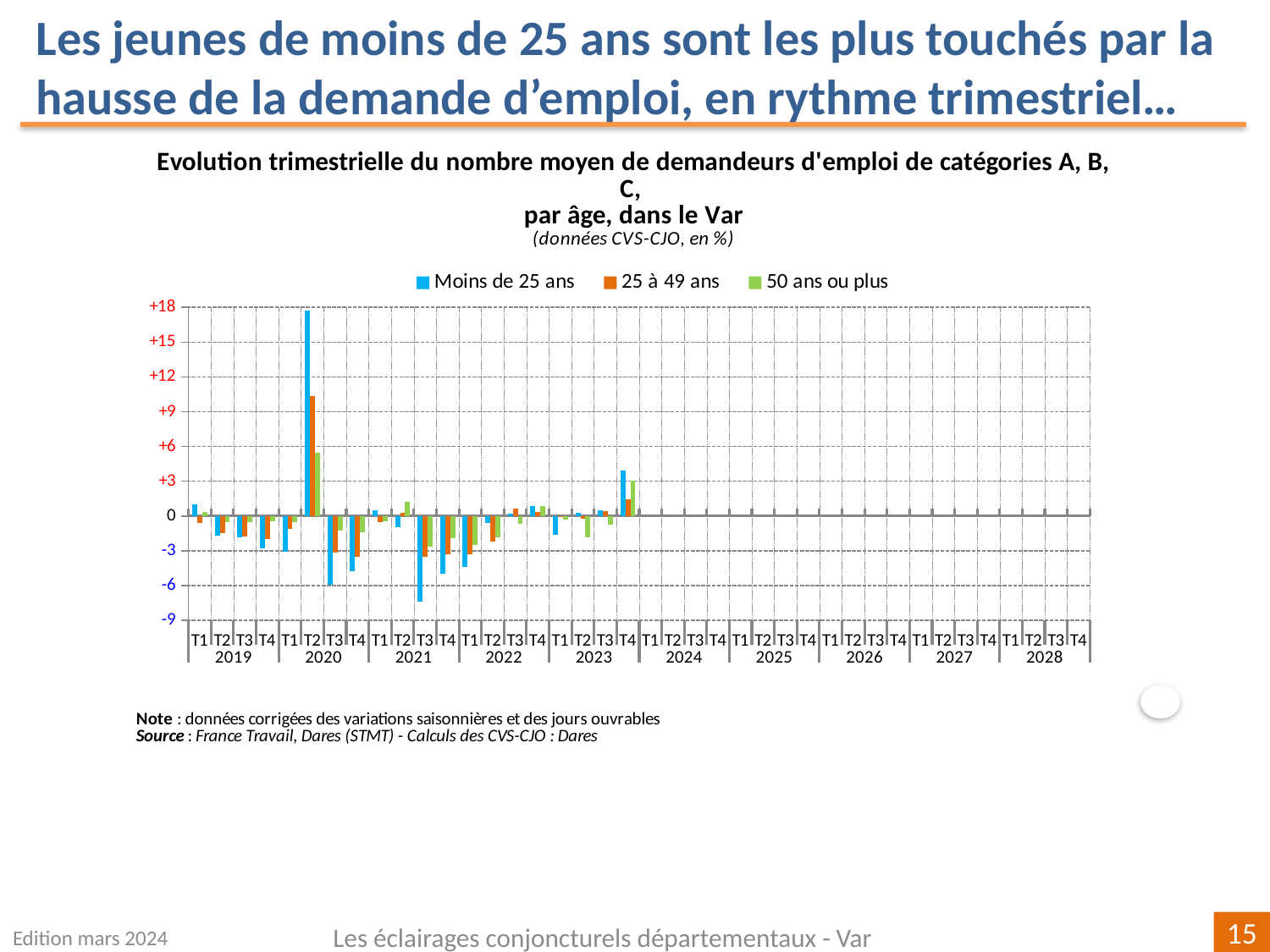
Is the value for '25 à 49 ans' in T2 2020 greater or less than +9? greater In T2 2020, which series has the larger value: 'Moins de 25 ans' or '50 ans ou plus'? Moins de 25 ans Is the value for 'Moins de 25 ans' in T4 2023 greater or less than +3? greater In which quarter does the 'Moins de 25 ans' series reach its highest value? T2 2020 How many series does the legend list? 3 Is the value for 'Moins de 25 ans' in T2 2020 greater or less than +15? greater How many years are labelled along the x axis? 10 What kind of chart is shown on the slide? Bar chart What is the last year on the x axis for which bars are plotted? 2023 Which series is shown in blue in the legend? Moins de 25 ans In which quarter does the 'Moins de 25 ans' series reach its lowest value? T3 2021